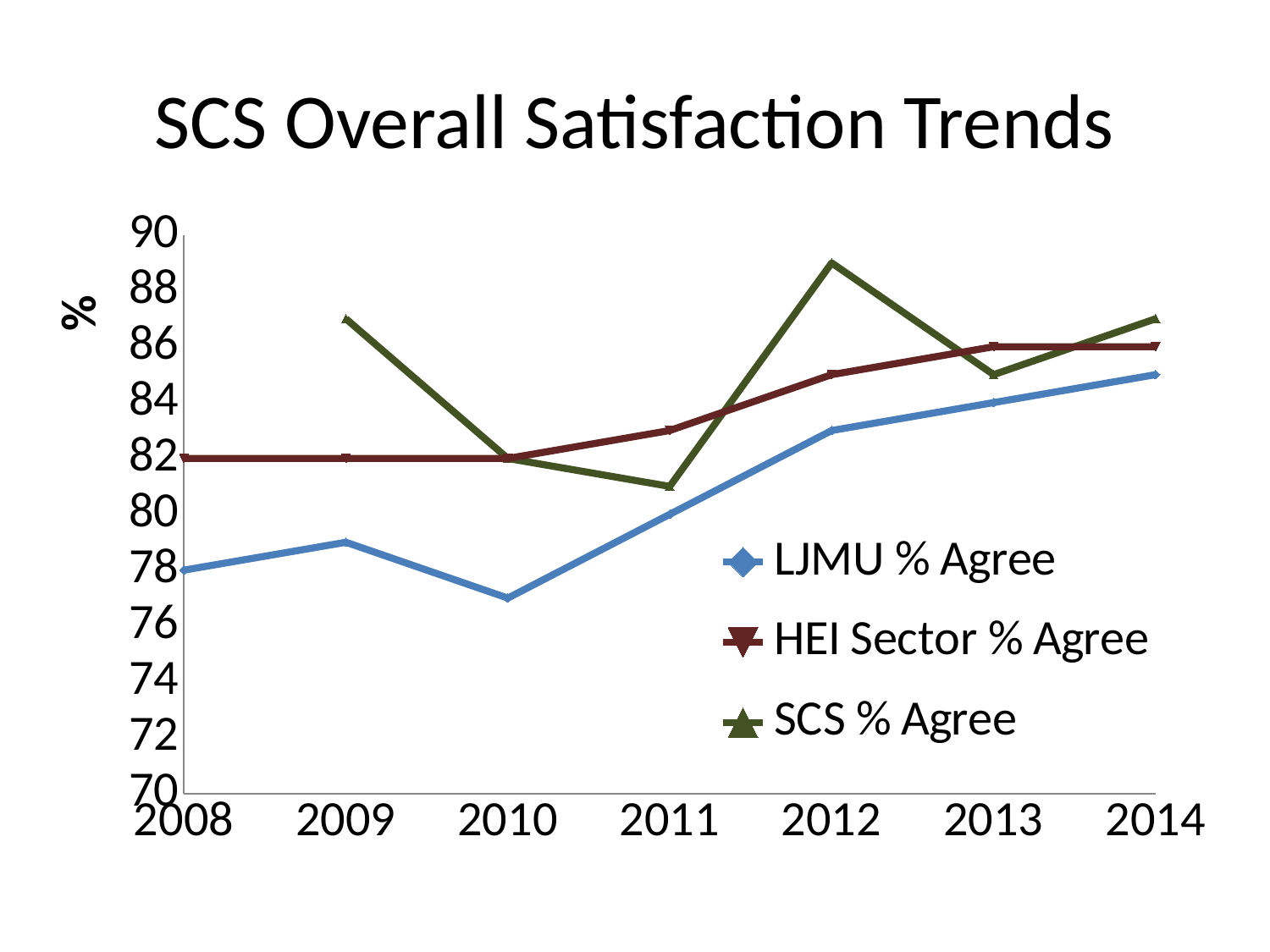
In 2012, which is higher: HEI Sector % Agree or LJMU % Agree? HEI Sector % Agree How many series does the legend list? 3 Is the SCS % Agree value for 2011 greater or less than 82? less Is the SCS % Agree value for 2012 greater or less than 88? greater What kind of chart is shown on the slide? line chart In which year is SCS % Agree at its highest? 2012 In 2009, which is higher: SCS % Agree or LJMU % Agree? SCS % Agree Does LJMU % Agree rise or fall from 2010 to 2014? rise What is the label on the y axis? % How many years are shown on the x axis? 7 Is the LJMU % Agree value for 2010 greater or less than 78? less In which year is LJMU % Agree at its lowest? 2010